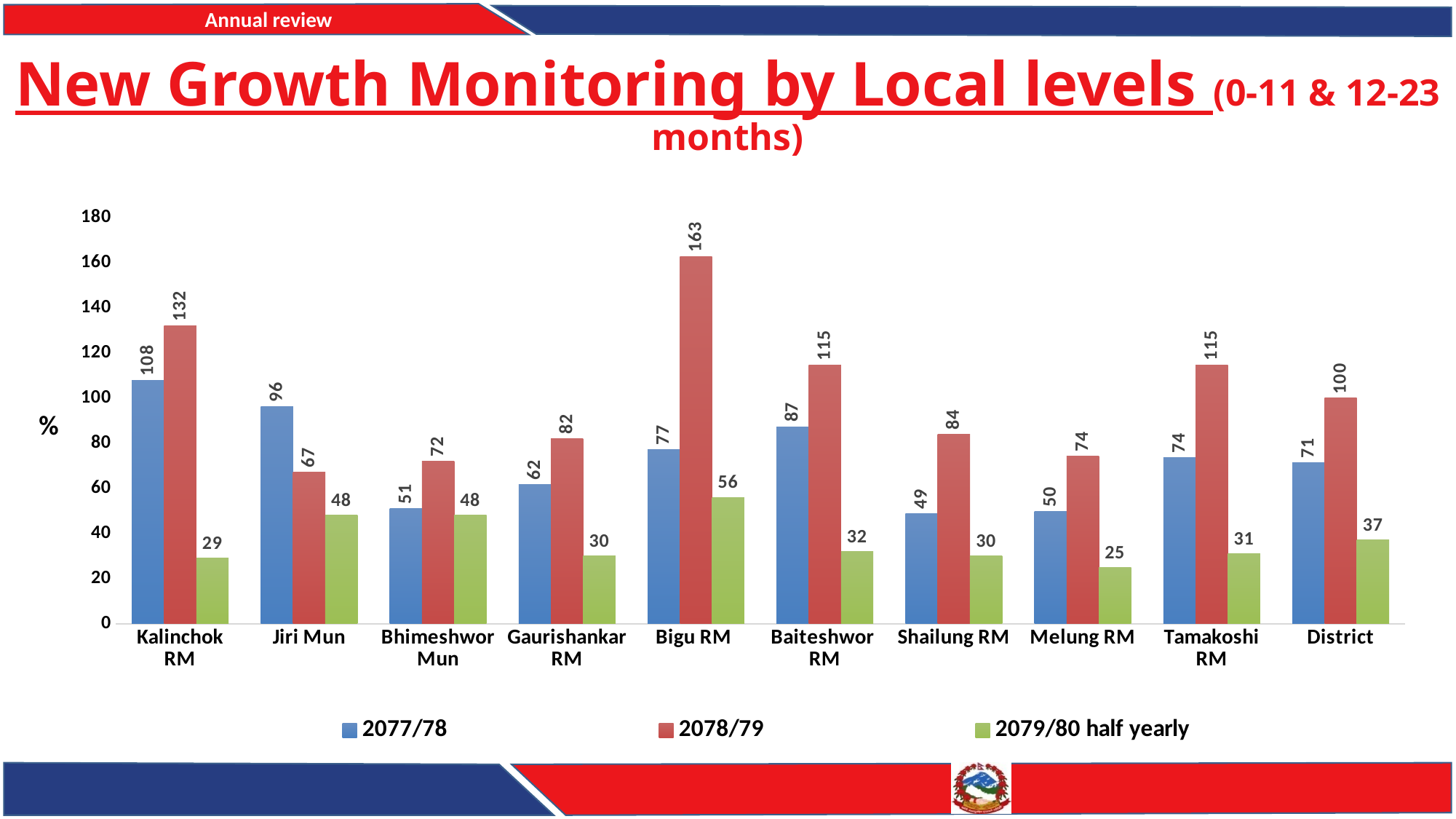
Which local level has the lowest 2079/80 half yearly value? Melung RM What is the 2077/78 value for Shailung RM? 49 Which series is shown in green in the legend? 2079/80 half yearly What kind of chart is shown on the slide? Bar chart What is the 2079/80 half yearly value for District? 37 What is the 2077/78 value for Kalinchok RM? 108 Which local level has the highest 2078/79 value? Bigu RM How many local levels (categories) are shown on the x axis? 10 How many series does the legend list? 3 Which is larger for Jiri Mun: the 2077/78 value or the 2078/79 value? 2077/78 What is the difference between the 2078/79 and 2077/78 values for Bigu RM? 86 What is the 2078/79 value for Bigu RM? 163